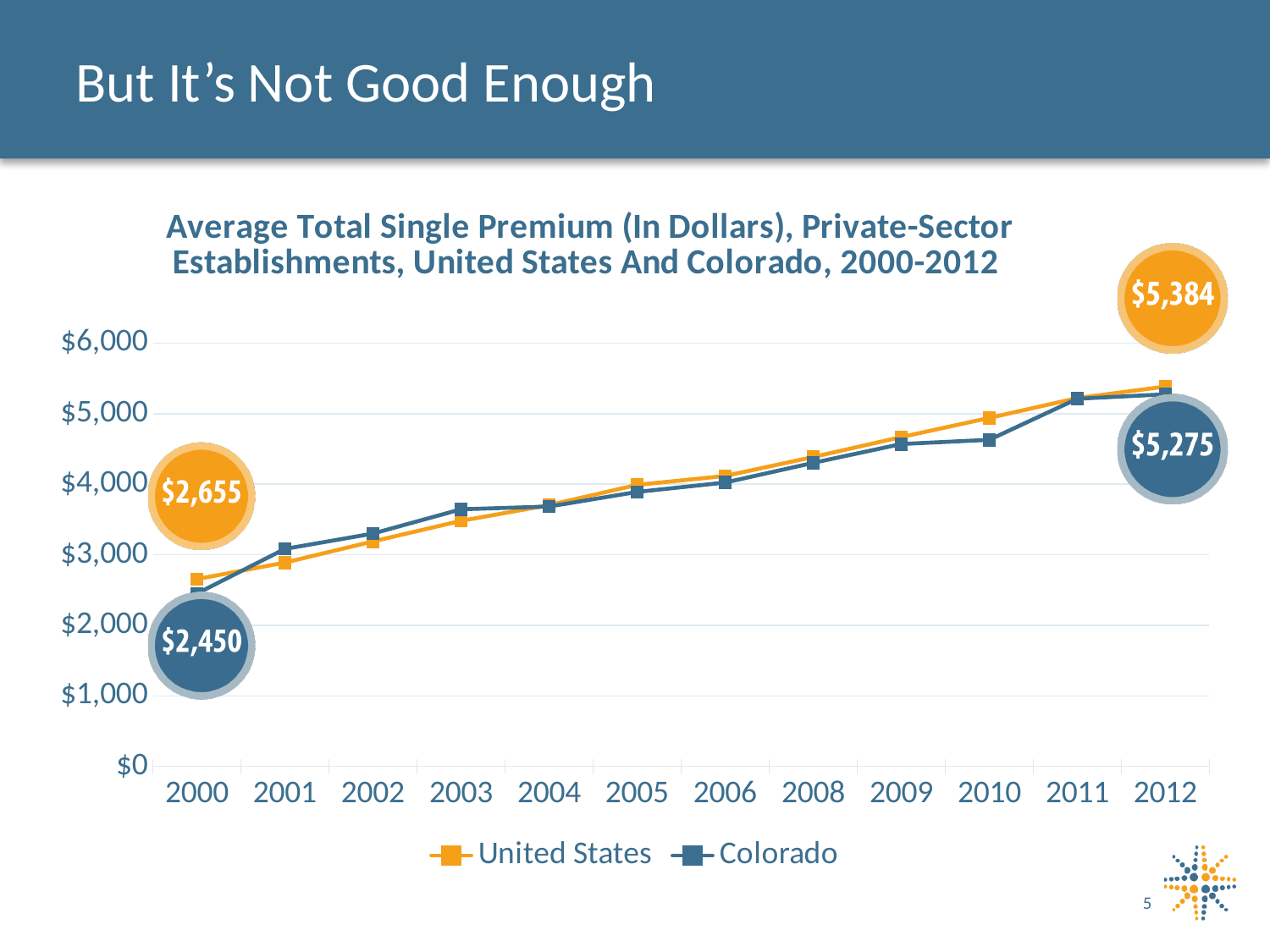
How many series does the legend list? 2 By how much did the United States average total single premium increase from 2000 to 2012? $2,729 What was the average total single premium for Colorado in 2000? $2,450 What kind of chart is shown on the slide? line chart What was the average total single premium for the United States in 2000? $2,655 Is the value for Colorado in 2010 greater or less than $5,000? less By how much did the Colorado average total single premium increase from 2000 to 2012? $2,825 In 2000, which had the higher average total single premium, the United States or Colorado? United States What was the average total single premium for the United States in 2012? $5,384 How many years are shown on the x axis? 12 What is the difference between the United States and Colorado average total single premium in 2012? $109 What was the average total single premium for Colorado in 2012? $5,275